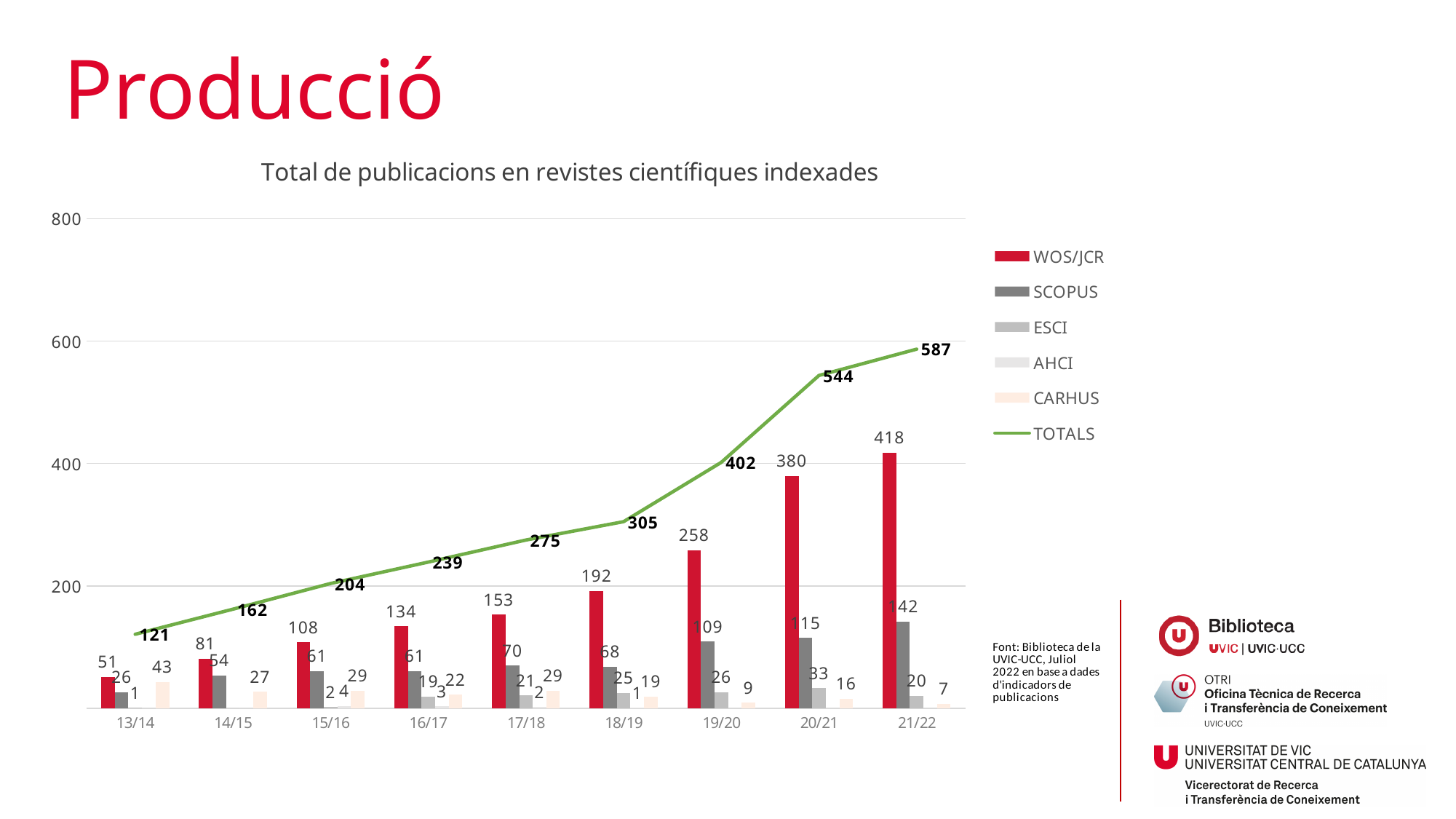
How many series does the legend list? 6 Which is larger, the SCOPUS value for 21/22 or the WOS/JCR value for 16/17? SCOPUS value for 21/22 What is the WOS/JCR value for 20/21? 380 What is the TOTALS value for 21/22? 587 Does the TOTALS line rise or fall from 13/14 to 21/22? rises Which year has the highest WOS/JCR value? 21/22 What is the CARHUS value for 13/14? 43 What is the title of the chart? Total de publicacions en revistes científiques indexades What is the difference between the TOTALS values for 21/22 and 20/21? 43 What is the SCOPUS value for 19/20? 109 How many years are shown on the x axis? 9 Which year has the lowest TOTALS value? 13/14